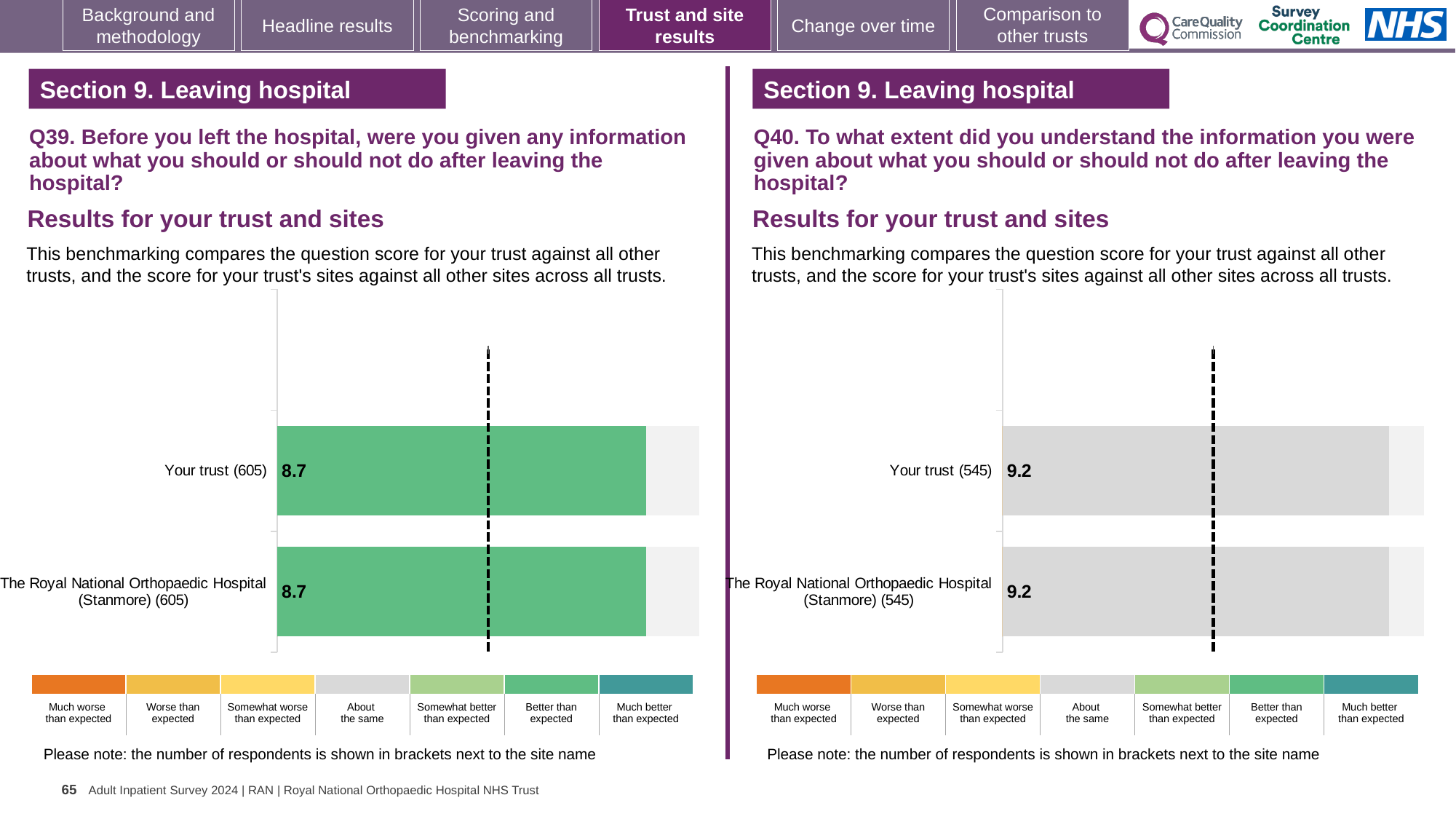
What kind of chart is used on the left (Q39)? Bar chart On the left chart (Q39), what is the score for The Royal National Orthopaedic Hospital (Stanmore)? 8.7 On the right chart (Q40), what is the score for Your trust? 9.2 On the left chart (Q39), what is the difference between the score for Your trust and the score for The Royal National Orthopaedic Hospital (Stanmore)? 0 On the left chart (Q39), what is the score for Your trust? 8.7 On the right chart (Q40), what is the difference between the score for Your trust and the score for The Royal National Orthopaedic Hospital (Stanmore)? 0 On the right chart (Q40), what is the score for The Royal National Orthopaedic Hospital (Stanmore)? 9.2 How many bars are plotted on the right chart (Q40)? 2 According to the colour key, which benchmark category do the grey bars on the right chart (Q40) represent? About the same On the right chart (Q40), how many respondents are shown in brackets for The Royal National Orthopaedic Hospital (Stanmore)? 545 How many bars are plotted on the left chart (Q39)? 2 On the left chart (Q39), how many respondents are shown in brackets for Your trust? 605